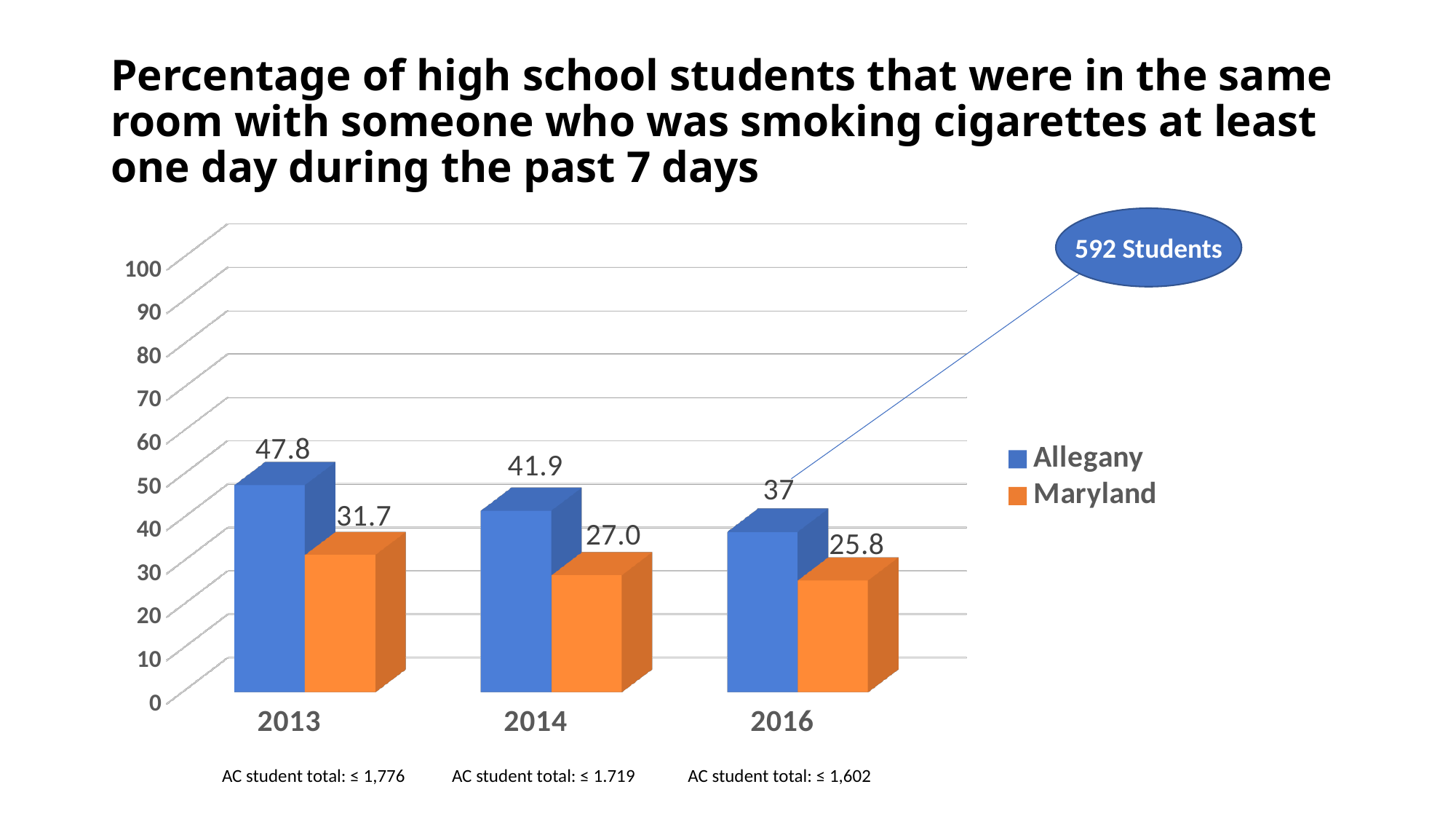
What is the value for Maryland in 2014? 27.0 In which year is the Allegany value highest? 2013 What kind of chart is shown on the slide? Bar chart How many series does the legend list? 2 What is the value for Maryland in 2016? 25.8 In which year is the Maryland value lowest? 2016 Do the Allegany values rise or fall from 2013 to 2016? Fall How many years are shown on the x axis? 3 What is the value for Allegany in 2013? 47.8 Which is larger in 2014, the Allegany value or the Maryland value? Allegany What is the value for Allegany in 2016? 37 What is the difference between the Allegany and Maryland values in 2013? 16.1